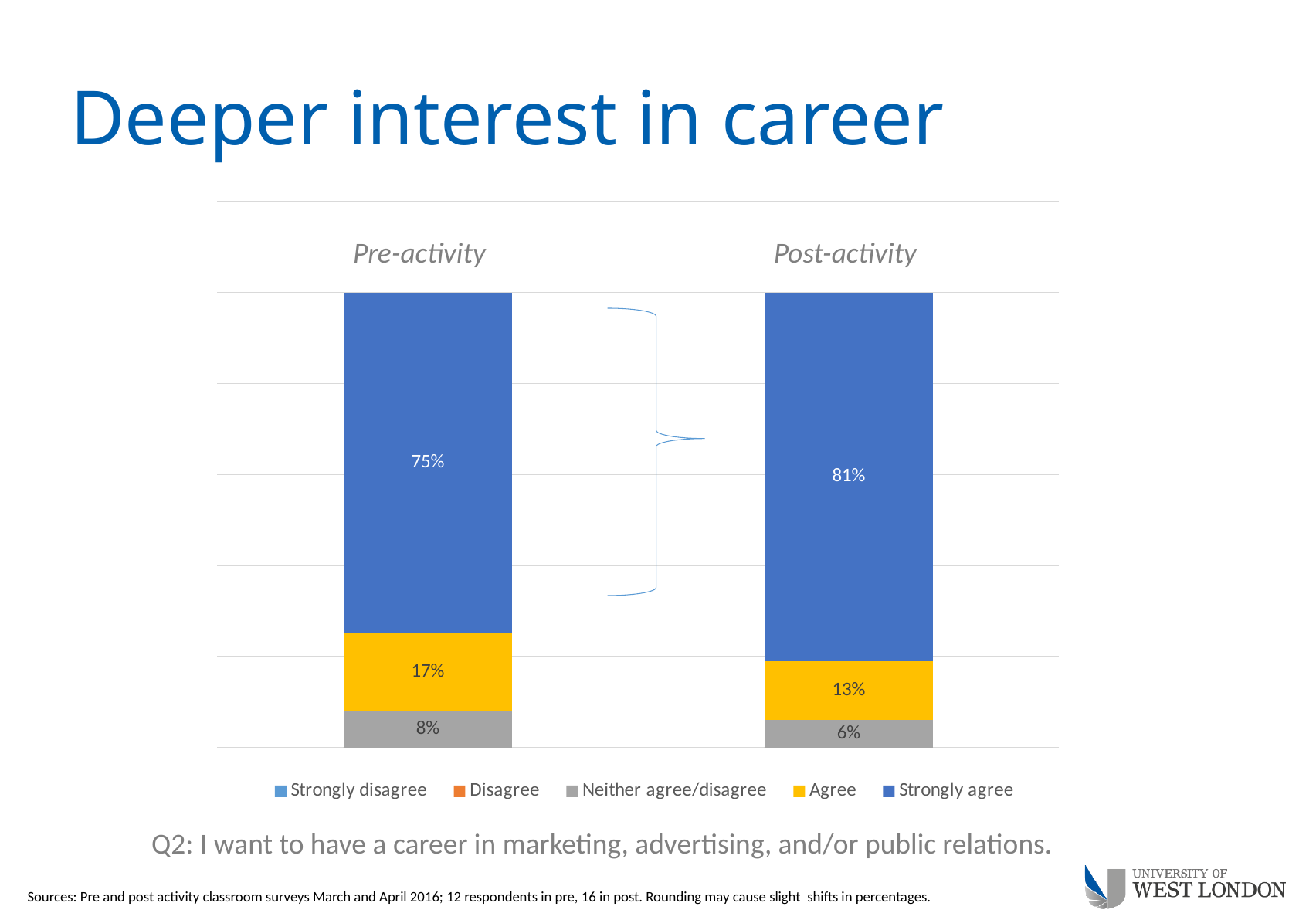
What percentage of Post-activity respondents selected Strongly agree? 81% What percentage of Pre-activity respondents selected Strongly agree? 75% What is the difference between the Agree shares for Pre-activity and Post-activity? 4 percentage points Which bar has the larger Neither agree/disagree share, Pre-activity or Post-activity? Pre-activity Which bar has the larger Strongly agree share, Pre-activity or Post-activity? Post-activity How many series does the legend list? 5 What is the Agree share for the Pre-activity bar? 17% How many bars are plotted in the chart? 2 By how many percentage points did the Strongly agree share change from Pre-activity to Post-activity? 6 percentage points What kind of chart is shown on the slide? Stacked bar chart What is the Neither agree/disagree share for the Post-activity bar? 6% Which response category is the largest segment in the Pre-activity bar? Strongly agree